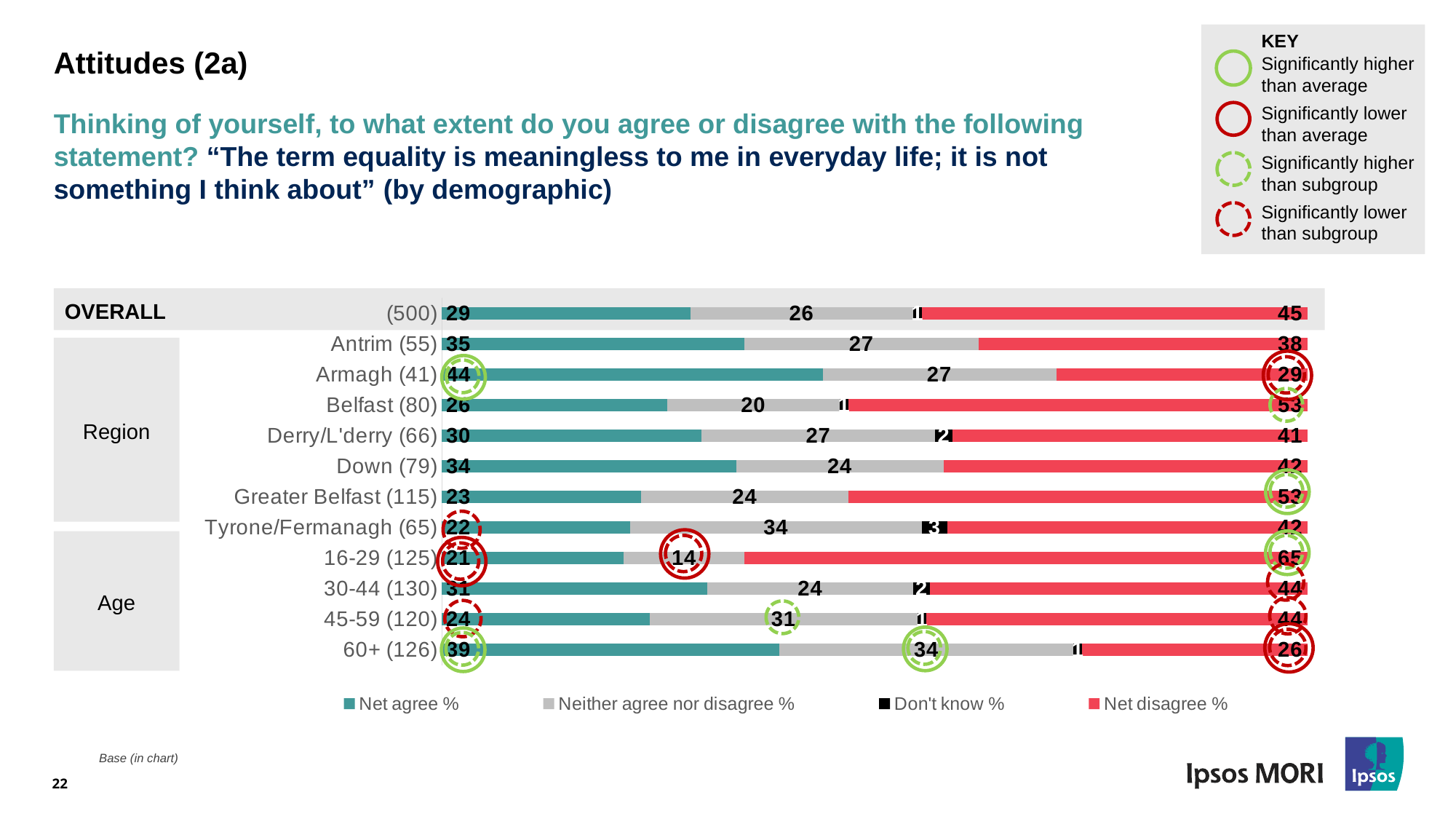
What is the Net disagree % value for OVERALL? 45 What is the Neither agree nor disagree % value for Tyrone/Fermanagh? 34 What is the difference between the Net agree % for Armagh and the Net agree % for OVERALL? 15 Which category has the highest Net disagree % value? 16-29 How many demographic categories (including OVERALL) are plotted in the chart? 12 Which category has the lowest Neither agree nor disagree % value? 16-29 Which has a larger Net disagree % value, Belfast or Antrim? Belfast What is the Net agree % value for the 60+ age group? 39 What is the Net agree % value for Armagh? 44 What kind of chart is shown on the slide? Stacked bar chart How many series does the chart legend list? 4 Which category has the highest Net agree % value? Armagh